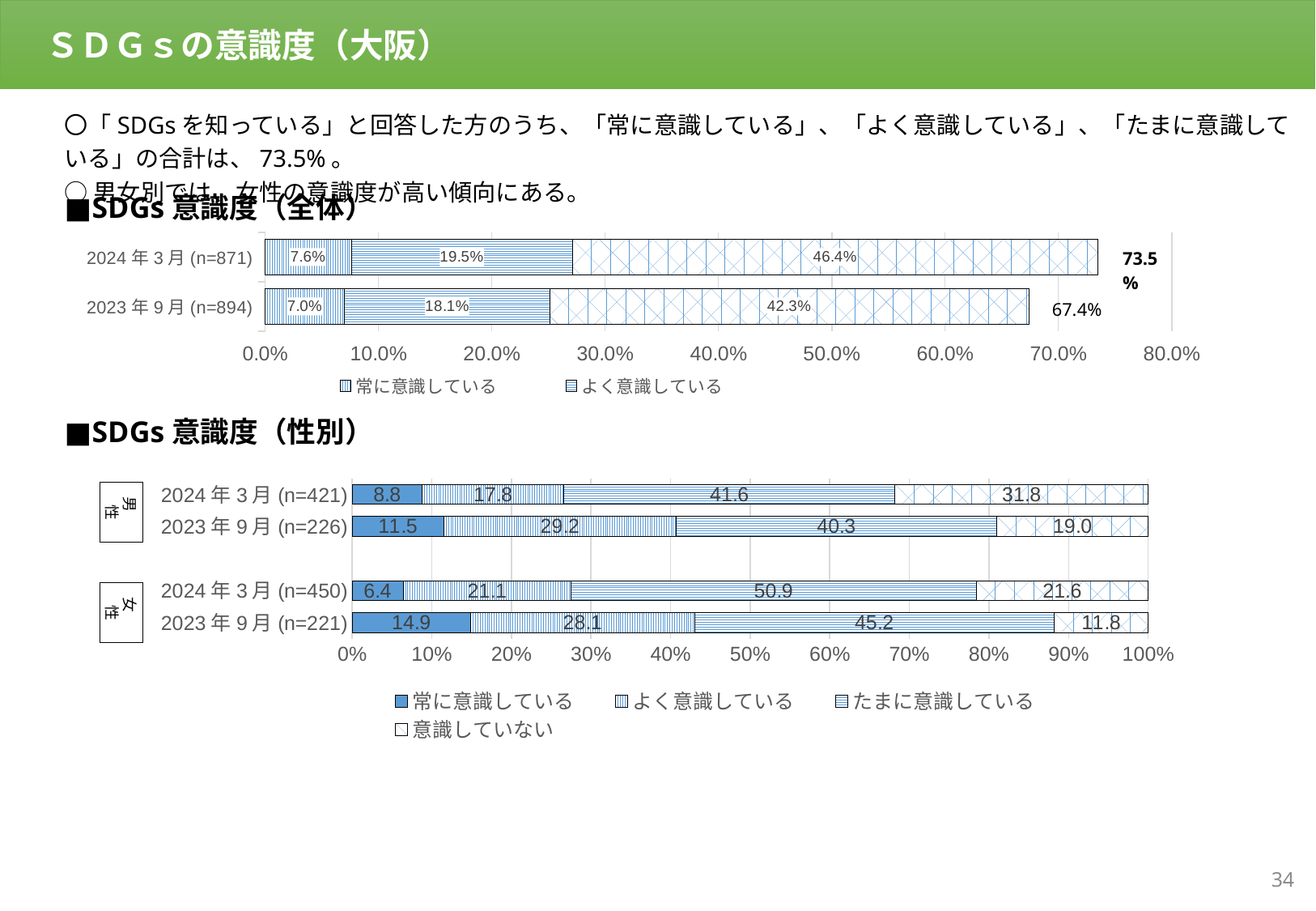
In the SDGs 意識度（全体） chart, what is the difference between the よく意識している values for 2024年3月 and 2023年9月? 1.4% In the SDGs 意識度（性別） chart, which bar has the highest たまに意識している value? 女性 2024年3月 (n=450) In the SDGs 意識度（全体） chart, what is the total shown at the end of the 2024年3月 (n=871) bar? 73.5% In the SDGs 意識度（性別） chart, what is the difference between the よく意識している values for 男性 2023年9月 and 男性 2024年3月? 11.4 In the SDGs 意識度（性別） chart, what is the 常に意識している value for 女性 2023年9月 (n=221)? 14.9 In the SDGs 意識度（性別） chart, what is the 意識していない value for 男性 2024年3月 (n=421)? 31.8 In the SDGs 意識度（性別） chart, which bar has the lowest 意識していない value? 女性 2023年9月 (n=221) In the SDGs 意識度（全体） chart, what is the value of 常に意識している for 2024年3月 (n=871)? 7.6% In the SDGs 意識度（全体） chart, what is the value of たまに意識している (the third segment) for 2023年9月 (n=894)? 42.3% In the SDGs 意識度（全体） chart, which bar has the larger total, 2024年3月 or 2023年9月? 2024年3月 How many series does the legend of the SDGs 意識度（性別） chart list? 4 What type of chart is the SDGs 意識度（性別） chart? Stacked bar chart